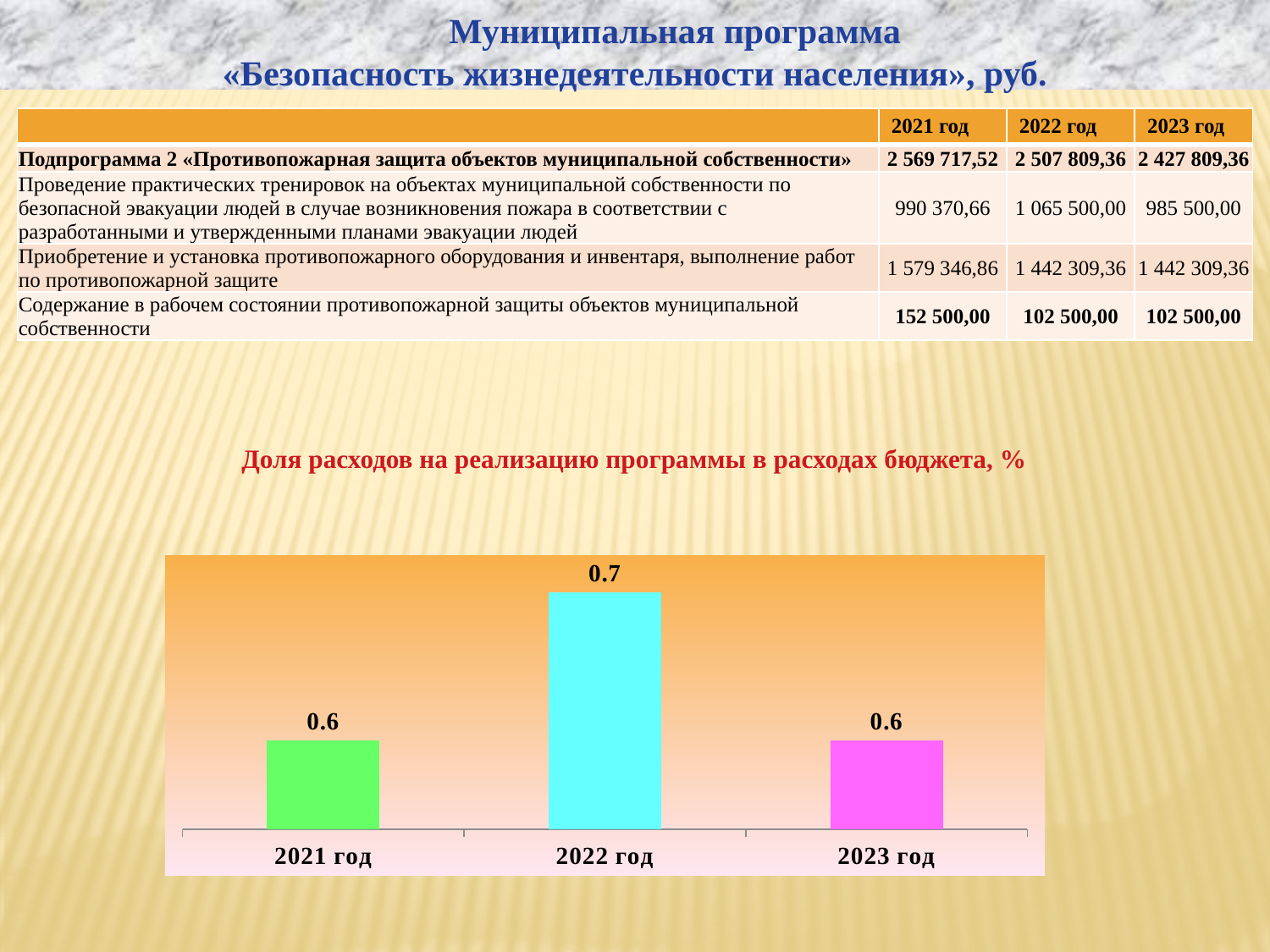
What kind of chart is shown on the slide? bar chart What colour is the bar for 2022 год? cyan What is the title of the chart? Доля расходов на реализацию программы в расходах бюджета, % How many categories are shown on the x axis of the chart? 3 What is the value for 2021 год in the chart? 0.6 Which year has the highest value in the chart? 2022 год What is the difference between the values for 2022 год and 2021 год? 0.1 Does the value rise or fall from 2022 год to 2023 год? fall Which is larger, the value for 2022 год or the value for 2023 год? 2022 год What is the value for 2022 год in the chart? 0.7 What is the value for 2023 год in the chart? 0.6